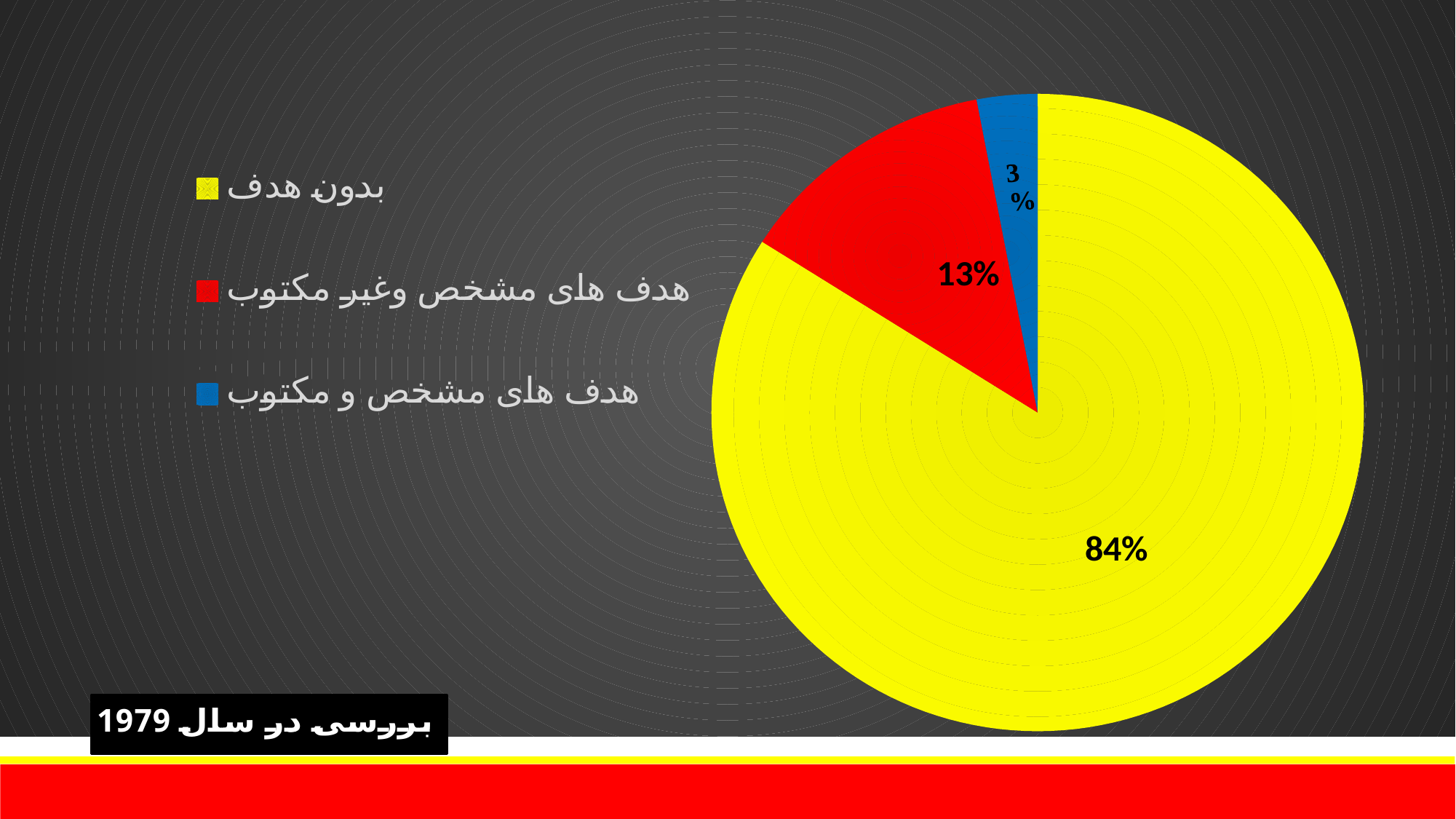
How many slices does the pie chart have? 3 Which slice is larger: "هدف های مشخص وغیر مکتوب" or "هدف های مشخص و مکتوب"? هدف های مشخص وغیر مکتوب Which category has the largest slice of the pie? بدون هدف What percentage of the pie is labelled for the slice "بدون هدف"? 84% What kind of chart is shown on the slide? pie chart What percentage is shown for the slice "هدف های مشخص وغیر مکتوب"? 13% How many entries does the legend list? 3 What year is mentioned in the caption text at the bottom left of the slide? 1979 What percentage is shown for the slice "هدف های مشخص و مکتوب"? 3% What colour is the slice for "بدون هدف"? yellow Which category has the smallest slice of the pie? هدف های مشخص و مکتوب What is the difference in percentage points between the "بدون هدف" slice and the "هدف های مشخص وغیر مکتوب" slice? 71